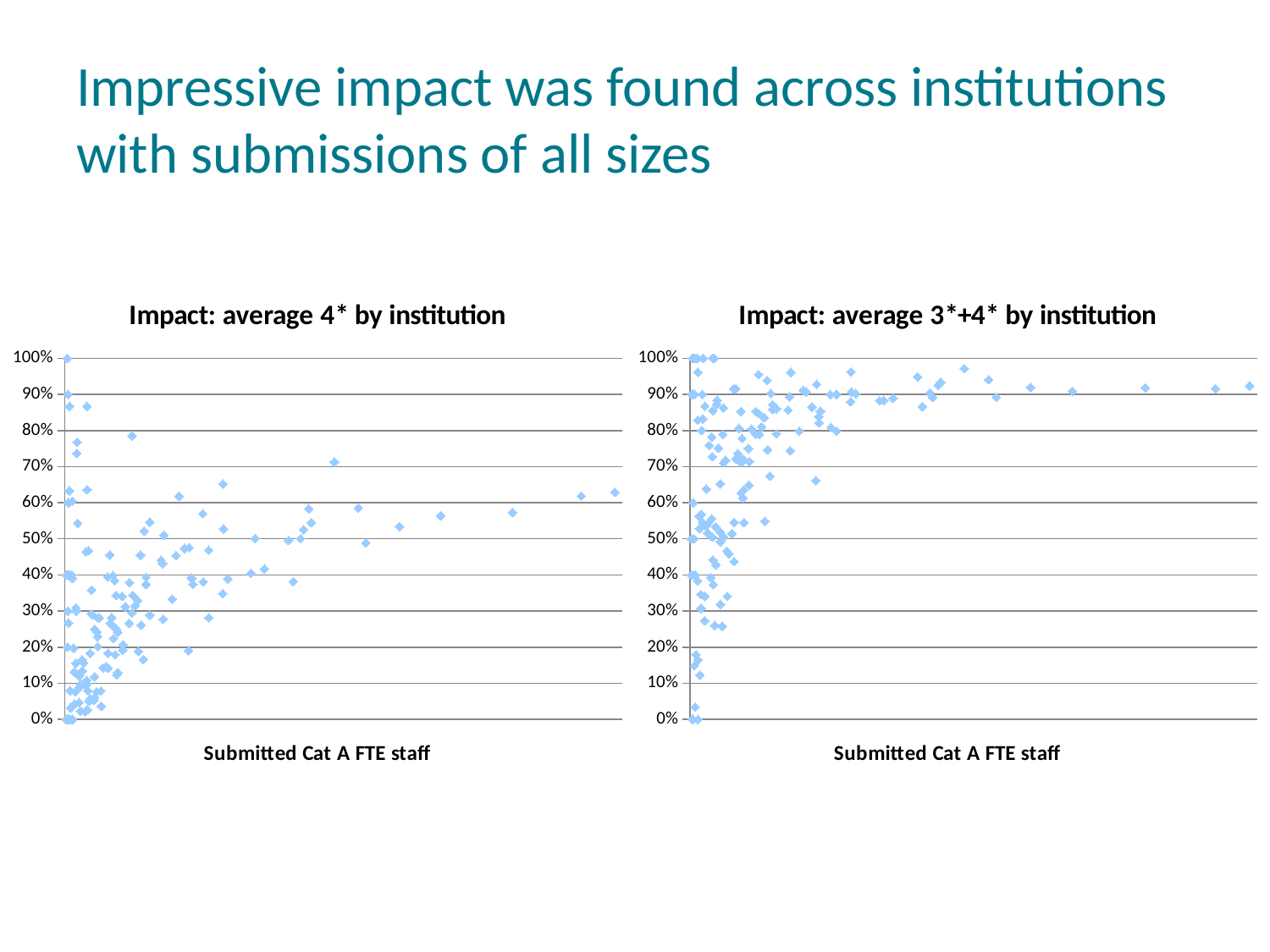
What kind of chart is the right chart, 'Impact: average 3*+4* by institution'? Scatter chart What is the x-axis label of the right chart, 'Impact: average 3*+4* by institution'? Submitted Cat A FTE staff In the left chart, 'Impact: average 4* by institution', what is the highest value shown on the y axis? 100% In the right chart, 'Impact: average 3*+4* by institution', do the plotted values generally rise or fall as the x-axis value increases? Rise What is the title of the left chart? Impact: average 4* by institution Which chart has its points concentrated at higher percentage values, the left chart 'Impact: average 4* by institution' or the right chart 'Impact: average 3*+4* by institution'? Impact: average 3*+4* by institution In the left chart, 'Impact: average 4* by institution', do the plotted values generally rise or fall as the x-axis value increases? Rise What kind of chart is the left chart, 'Impact: average 4* by institution'? Scatter chart How many charts are shown on the slide? 2